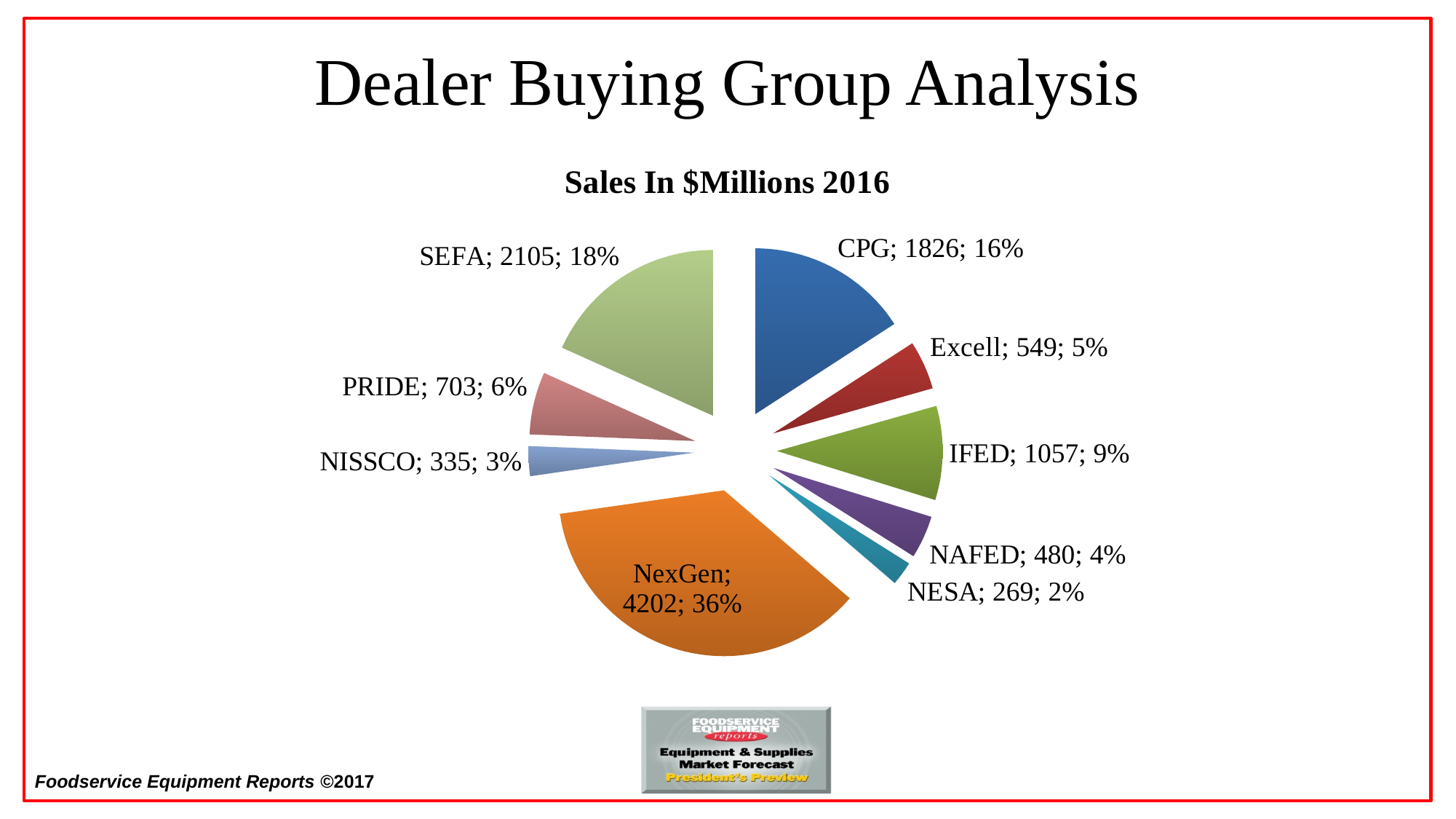
What share of the pie does NESA account for? 2% What is the chart's title? Sales In $Millions 2016 How many slices does the pie chart have? 9 Which buying group has the lowest sales? NESA What is the difference in sales between SEFA and CPG? 279 Which has higher sales, PRIDE or Excell? PRIDE What is the difference in sales between NAFED and NISSCO? 145 What share of the pie does NexGen account for? 36% What kind of chart is shown on the slide? pie chart What is the sales value for IFED? 1057 What is the sales value for SEFA? 2105 Which buying group has the highest sales? NexGen